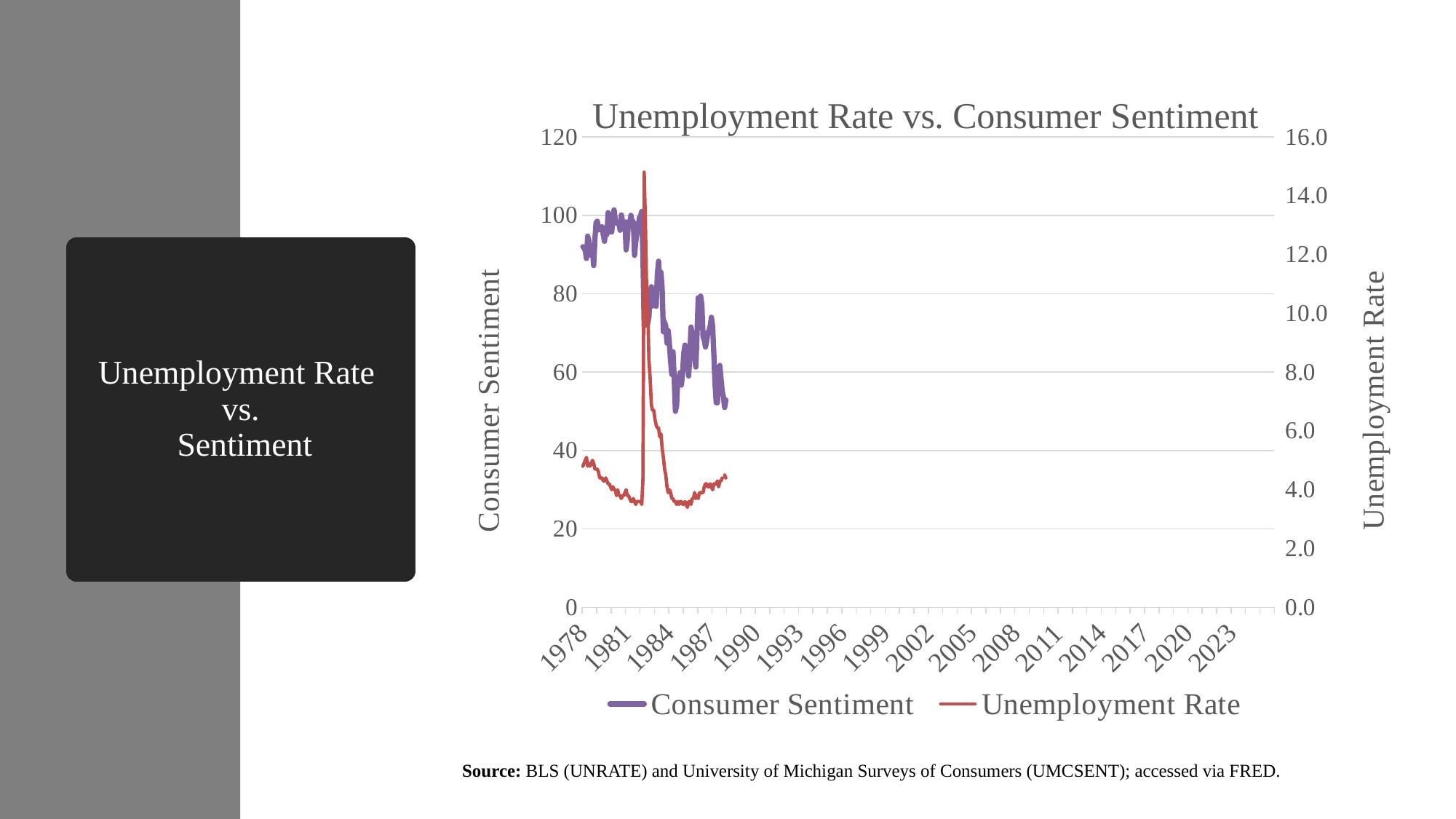
How many series does the chart legend list? 2 Is the highest value of the Consumer Sentiment series greater or less than 90? greater Is the lowest value of the Consumer Sentiment series greater or less than 60? less Is the peak value of the Unemployment Rate series greater or less than 14.0? greater Which series is drawn with the purple line? Consumer Sentiment Does the Consumer Sentiment series overall rise or fall from its start in 1978 to its end around 1989? fall How many year labels are shown along the x axis? 16 What kind of chart is shown on the slide? line chart What is the title of the chart? Unemployment Rate vs. Consumer Sentiment